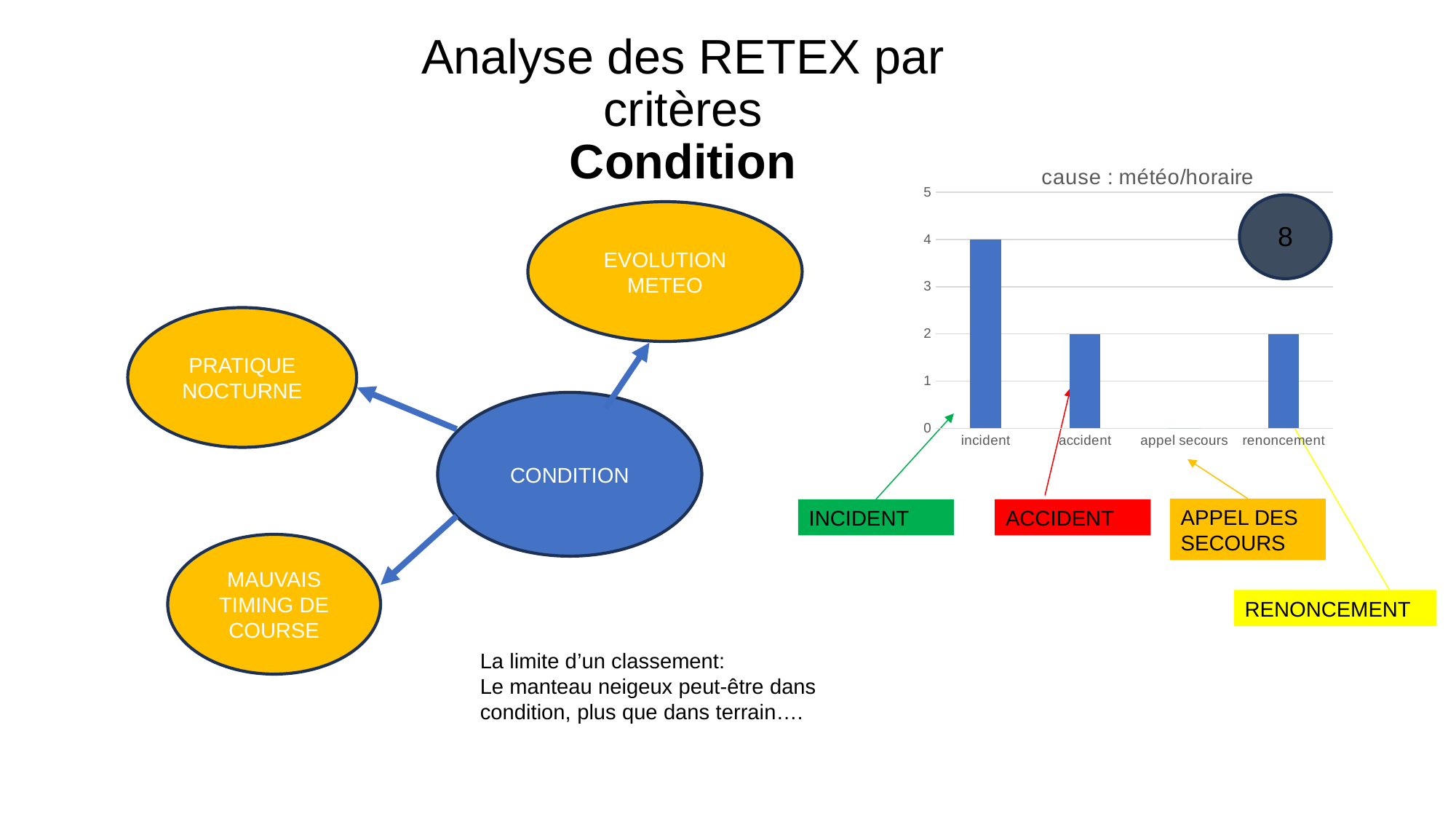
How many categories are shown on the x axis of the chart? 4 What kind of chart is shown on the slide? bar chart Which is larger, the value for incident or the value for renoncement? incident What is the value for incident in the chart? 4 What is the value for renoncement in the chart? 2 What is the highest value shown on the chart's vertical axis? 5 What is the value for accident in the chart? 2 Is the value for incident greater or less than 3? greater What is the title of the chart? cause : météo/horaire Which category has the lowest value in the chart? appel secours Which category has the highest value in the chart? incident What is the difference between the values for incident and accident? 2